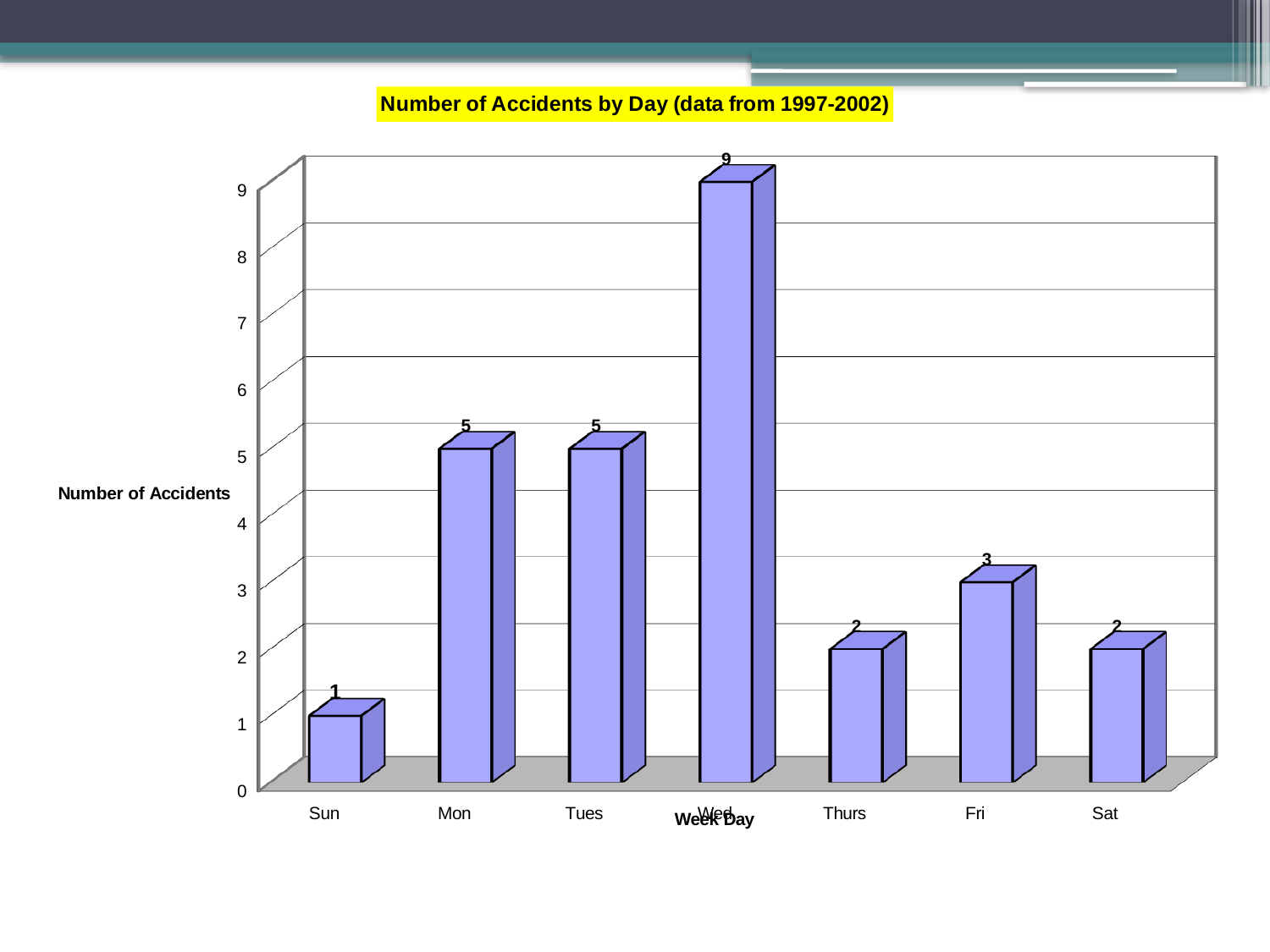
What is the title of the chart? Number of Accidents by Day (data from 1997-2002) What is the label of the x axis? Week Day What kind of chart is shown on the slide? bar chart What is the number of accidents on Sun? 1 What is the number of accidents on Wed? 9 Which day has the highest number of accidents? Wed What is the number of accidents on Fri? 3 What is the difference in the number of accidents between Wed and Mon? 4 How many days are shown on the x axis? 7 Which day has the lowest number of accidents? Sun Is the number of accidents on Wed greater or less than 8? greater Which has more accidents, Fri or Thurs? Fri